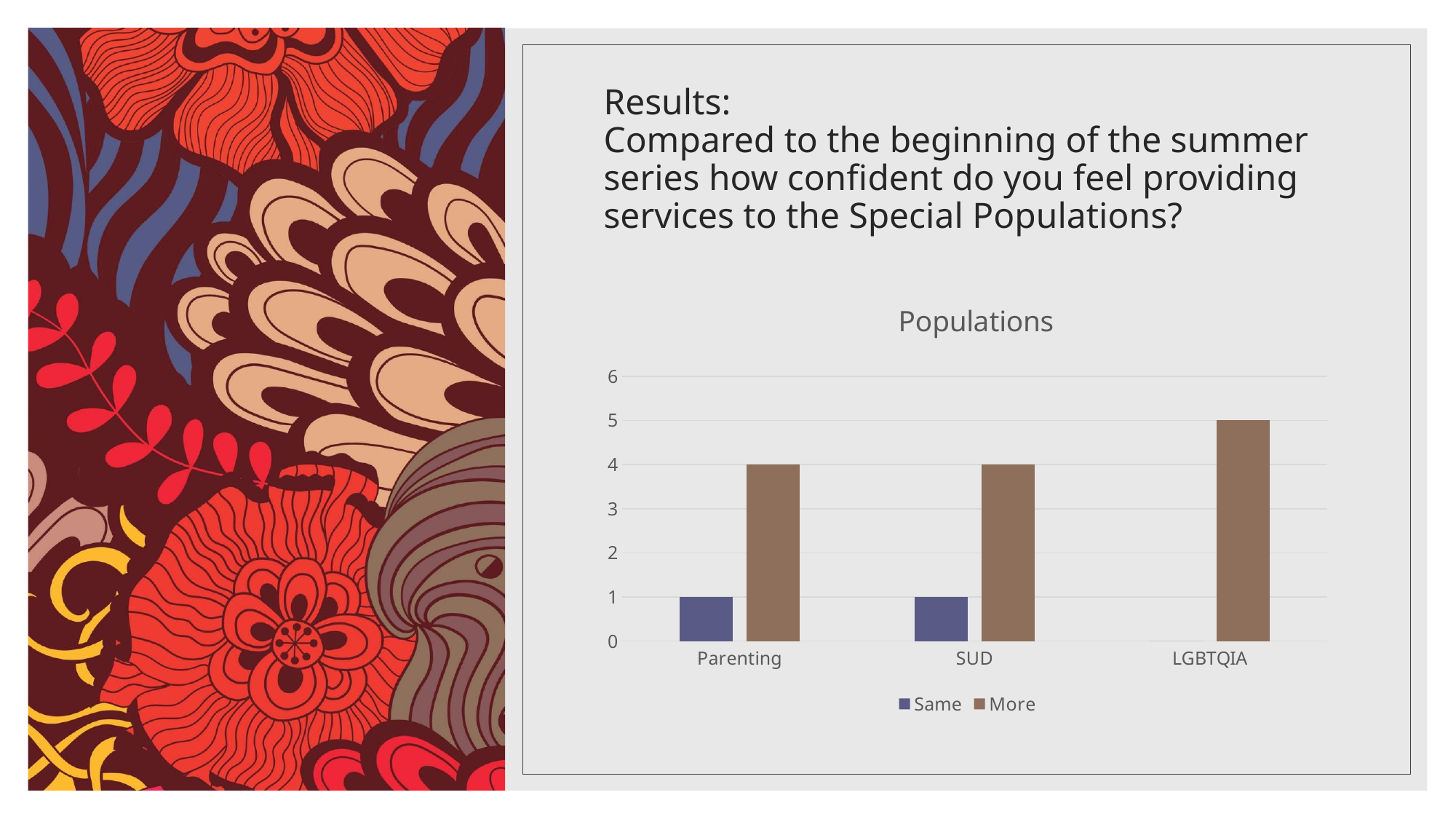
What is the title of the chart? Populations How many categories are shown on the x axis? 3 Which series is shown in brown in the legend? More What is the value of the More series for SUD? 4 Which is larger for SUD, the Same value or the More value? More What is the value of the Same series for Parenting? 1 How many series does the legend list? 2 What is the difference between the More and Same values for Parenting? 3 What type of chart is shown on the slide? bar chart Which category has the highest value for the More series? LGBTQIA What is the value of the More series for LGBTQIA? 5 Is the value of the More series for LGBTQIA greater or less than 4? greater